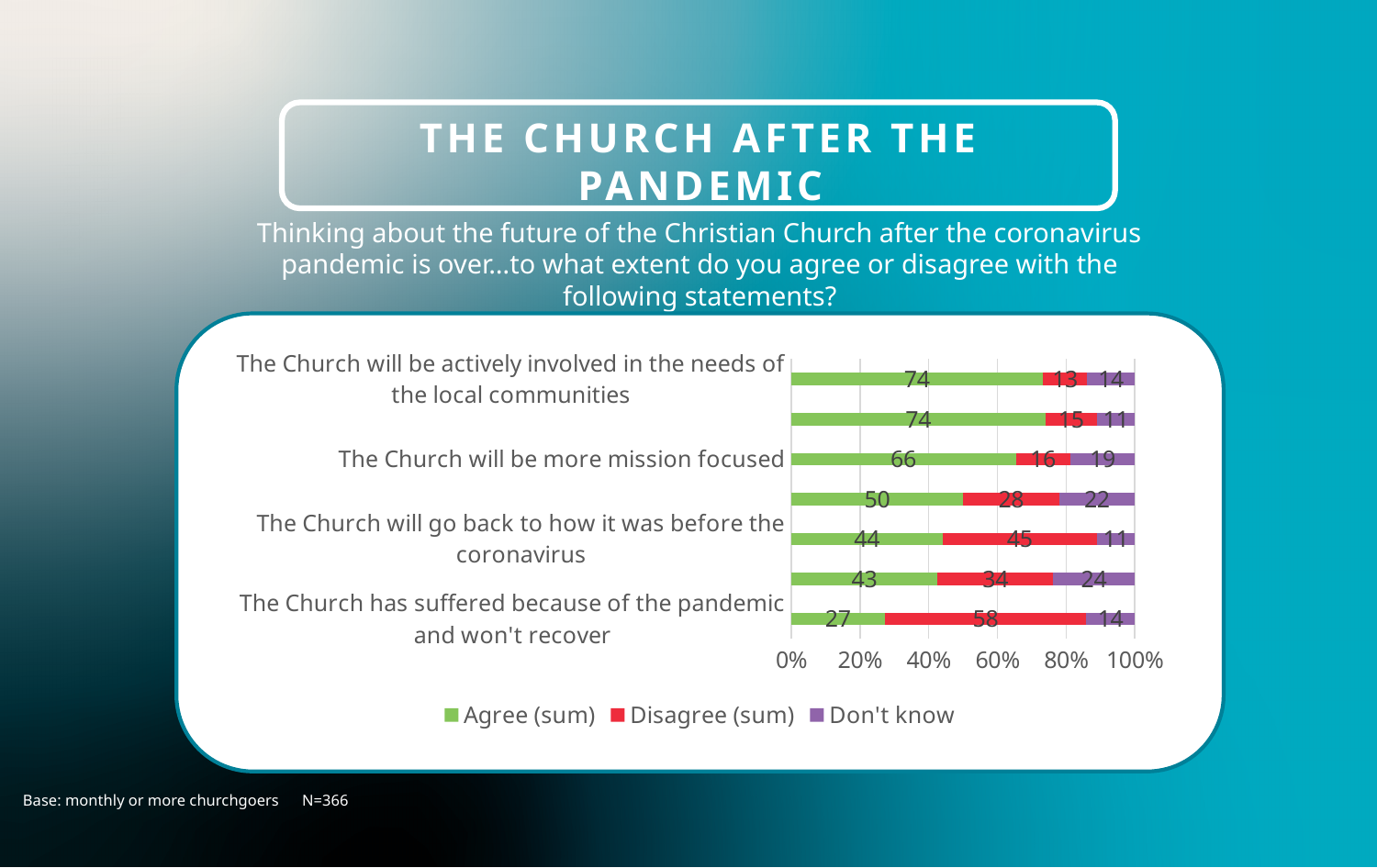
What colour represents the Don't know series in the chart? purple Which has the larger Disagree (sum) value: 'The Church will go back to how it was before the coronavirus' or 'The Church has suffered because of the pandemic and won't recover'? The Church has suffered because of the pandemic and won't recover What is the Agree (sum) value for 'The Church will go back to how it was before the coronavirus'? 44 Which labelled statement has the lowest Agree (sum) value? The Church has suffered because of the pandemic and won't recover What is the Agree (sum) value for 'The Church will be actively involved in the needs of the local communities'? 74 What kind of chart is shown on the slide? bar chart Which labelled statement has the highest Disagree (sum) value? The Church has suffered because of the pandemic and won't recover What is the Don't know value for 'The Church will be more mission focused'? 19 What is the Disagree (sum) value for 'The Church has suffered because of the pandemic and won't recover'? 58 What is the difference between the Agree (sum) values for 'The Church will be actively involved in the needs of the local communities' and 'The Church has suffered because of the pandemic and won't recover'? 47 How many bars are plotted in the chart? 7 How many series does the legend list? 3